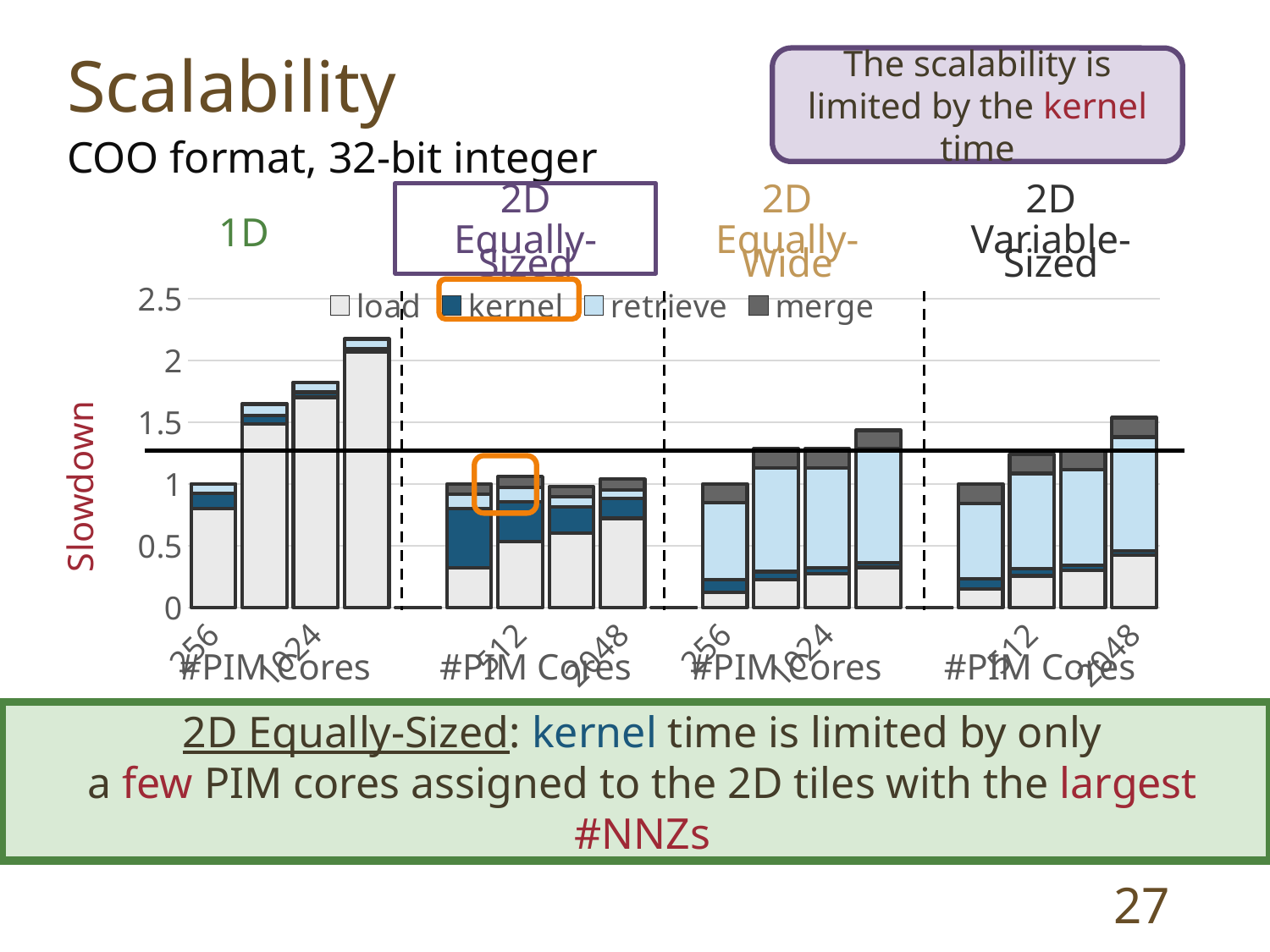
How many bars are plotted in each group of the chart? 4 What are the series names listed in the chart legend? load, kernel, retrieve, merge What kind of chart is shown on the slide? stacked bar chart Is the total slowdown for 2D Equally-Wide at 2048 PIM cores greater or less than 1.5? less What is the label of the y axis of the chart? Slowdown Within the 1D group, does the total slowdown rise or fall as the number of PIM cores increases? rise Which has the larger total slowdown at 2048 PIM cores: 1D or 2D Equally-Sized? 1D Which group and core count has the highest total slowdown bar in the chart? 1D at 2048 PIM cores How many partitioning schemes (bar groups) are shown in the chart? 4 Is the total slowdown for 1D at 512 PIM cores greater or less than 1.5? greater How many series does the chart legend list? 4 Is the total slowdown for 1D at 2048 PIM cores greater or less than 2? greater